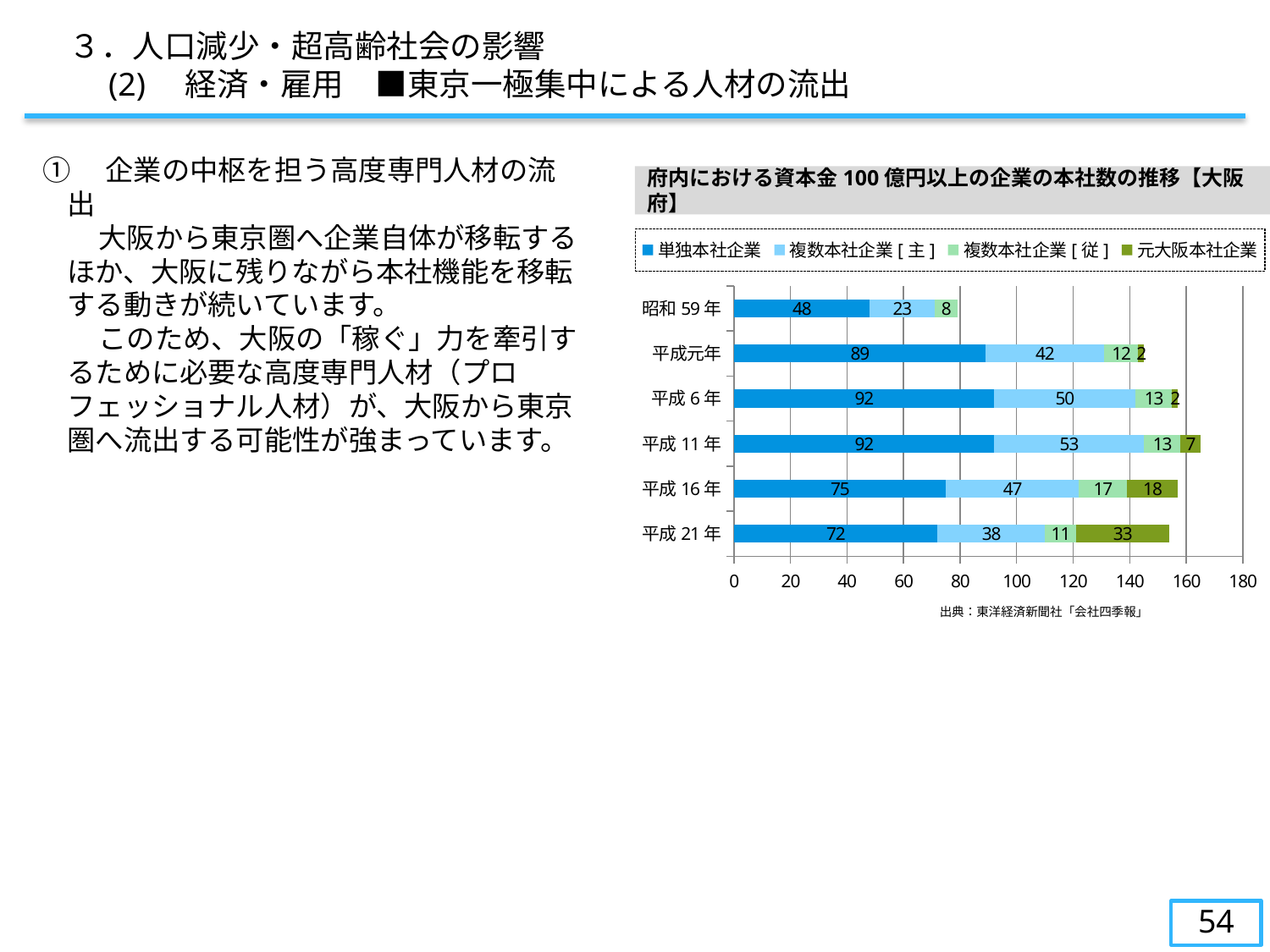
What is the value of 単独本社企業 for 平成21年? 72 Which is larger, the 複数本社企業[主] value for 平成16年 or for 平成21年? 平成16年 What is the value of 元大阪本社企業 for 平成16年? 18 Which year has the lowest value for 単独本社企業? 昭和59年 How many year categories are plotted on the chart? 6 Which year has the highest value for 元大阪本社企業? 平成21年 How many series does the legend list? 4 What is the difference between the 単独本社企業 values for 平成6年 and 平成21年? 20 What is the total of the stacked bar for 平成11年? 165 Is the total length of the bar for 昭和59年 greater or less than 100? less What type of chart is shown on the slide? stacked bar chart What is the value of 複数本社企業[主] for 平成11年? 53